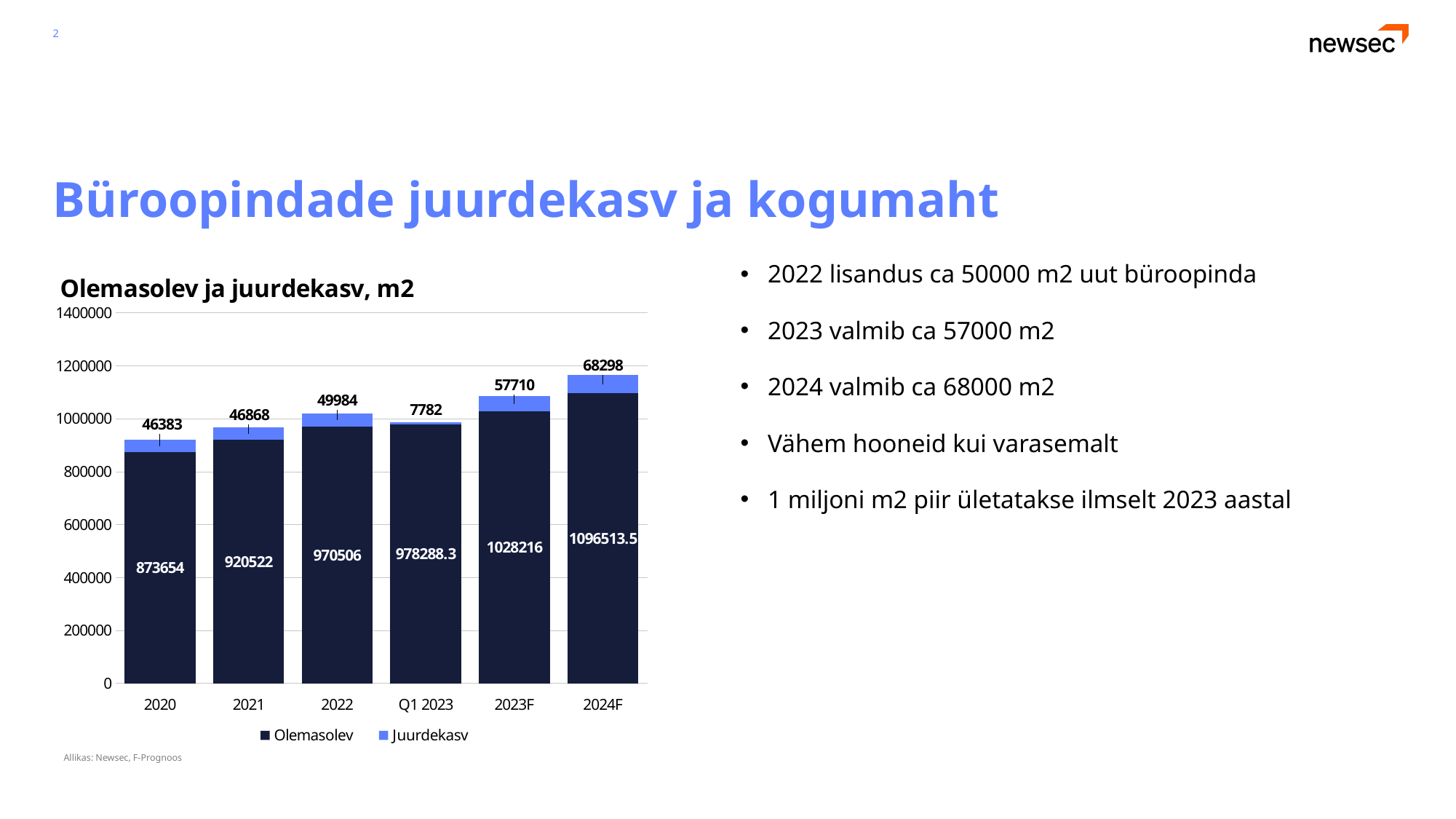
What is the Olemasolev value for 2020? 873654 What is the Olemasolev value for Q1 2023? 978288.3 Is the Olemasolev value for 2023F greater or less than 1000000? greater What is the total of the stacked bar for 2020? 920037 Which category has the highest Olemasolev value? 2024F What kind of chart is shown on the slide? Stacked bar chart Which is larger, the Juurdekasv value for 2022 or for 2021? 2022 How many series does the legend list? 2 What is the Juurdekasv value for 2024F? 68298 Which category has the lowest Juurdekasv value? Q1 2023 How many categories are shown on the x axis? 6 What is the difference between the Juurdekasv values for 2024F and 2023F? 10588